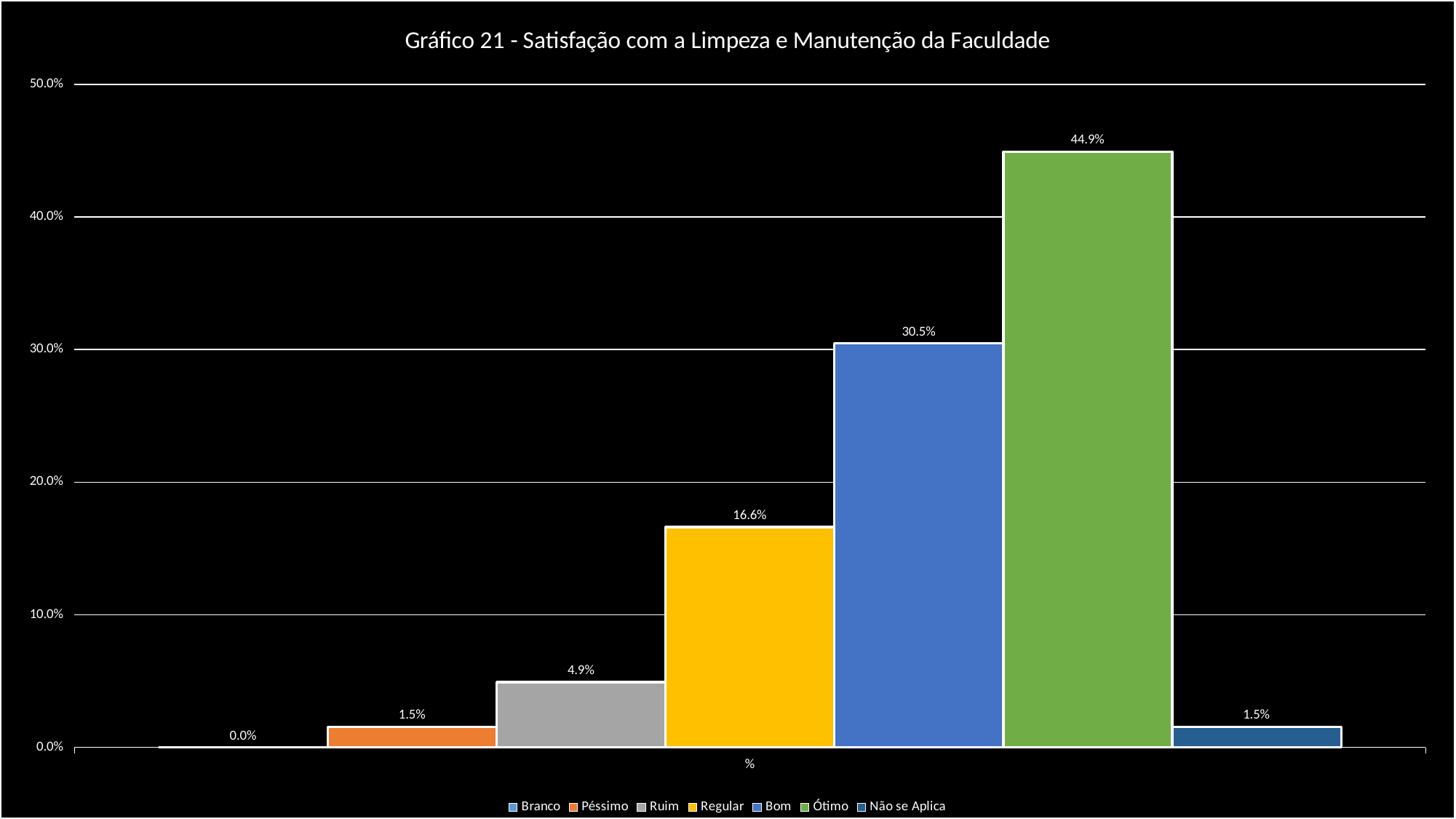
What is the value for Ótimo? 44.9% What is the value for Branco? 0.0% Which series has the highest value? Ótimo What is the value for Regular? 16.6% What is the title of the chart? Gráfico 21 - Satisfação com a Limpeza e Manutenção da Faculdade Which is larger, the value for Regular or the value for Ruim? Regular What is the difference between the values for Ótimo and Bom? 14.4% Which series has the lowest value? Branco What is the value for Bom? 30.5% How many series does the legend list? 7 What is the value for Ruim? 4.9% What kind of chart is shown? Bar chart